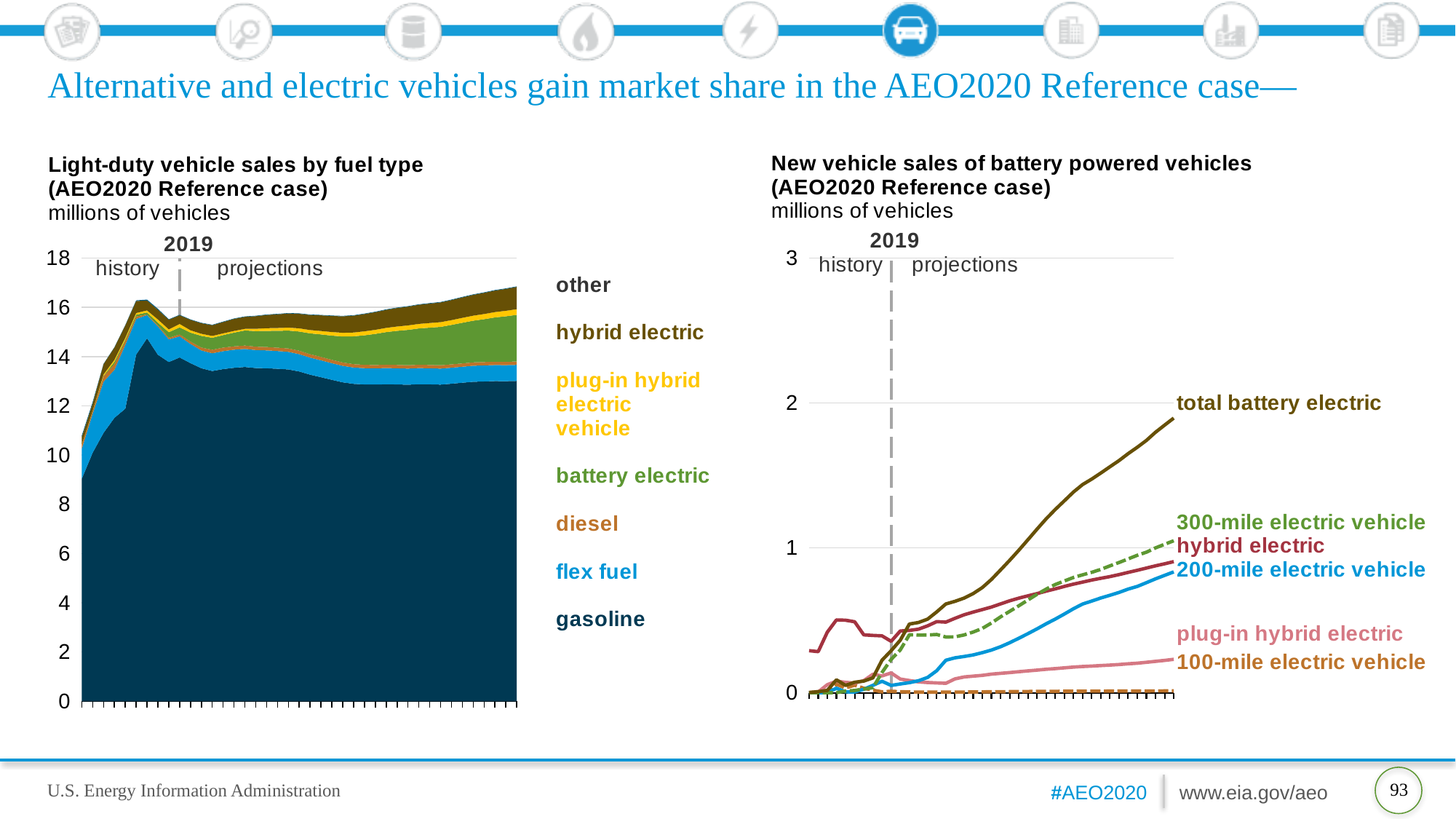
In the left chart, 'Light-duty vehicle sales by fuel type', how many fuel-type series are listed in the legend? 7 In the right chart, 'New vehicle sales of battery powered vehicles', which series has the lowest value at the end of the projection period? 100-mile electric vehicle In the right chart, 'New vehicle sales of battery powered vehicles', is the value for 200-mile electric vehicle at the end of the projection period greater or less than 1? less What type of chart is the right chart, 'New vehicle sales of battery powered vehicles'? line chart What year does the dashed vertical line separating history from projections mark in both charts? 2019 In the right chart, 'New vehicle sales of battery powered vehicles', how many series are labeled? 6 In the right chart, 'New vehicle sales of battery powered vehicles', does total battery electric rise or fall over the projection period? rise In the right chart, 'New vehicle sales of battery powered vehicles', is the value for total battery electric at the end of the projection period greater or less than 2? less In the right chart, 'New vehicle sales of battery powered vehicles', which series has the highest value at the end of the projection period? total battery electric In the right chart, 'New vehicle sales of battery powered vehicles', at the end of the projection period, which is larger: 200-mile electric vehicle or plug-in hybrid electric? 200-mile electric vehicle What type of chart is the left chart, 'Light-duty vehicle sales by fuel type'? stacked area chart In the left chart, 'Light-duty vehicle sales by fuel type', is the gasoline value at the end of the projection period greater or less than 12? greater